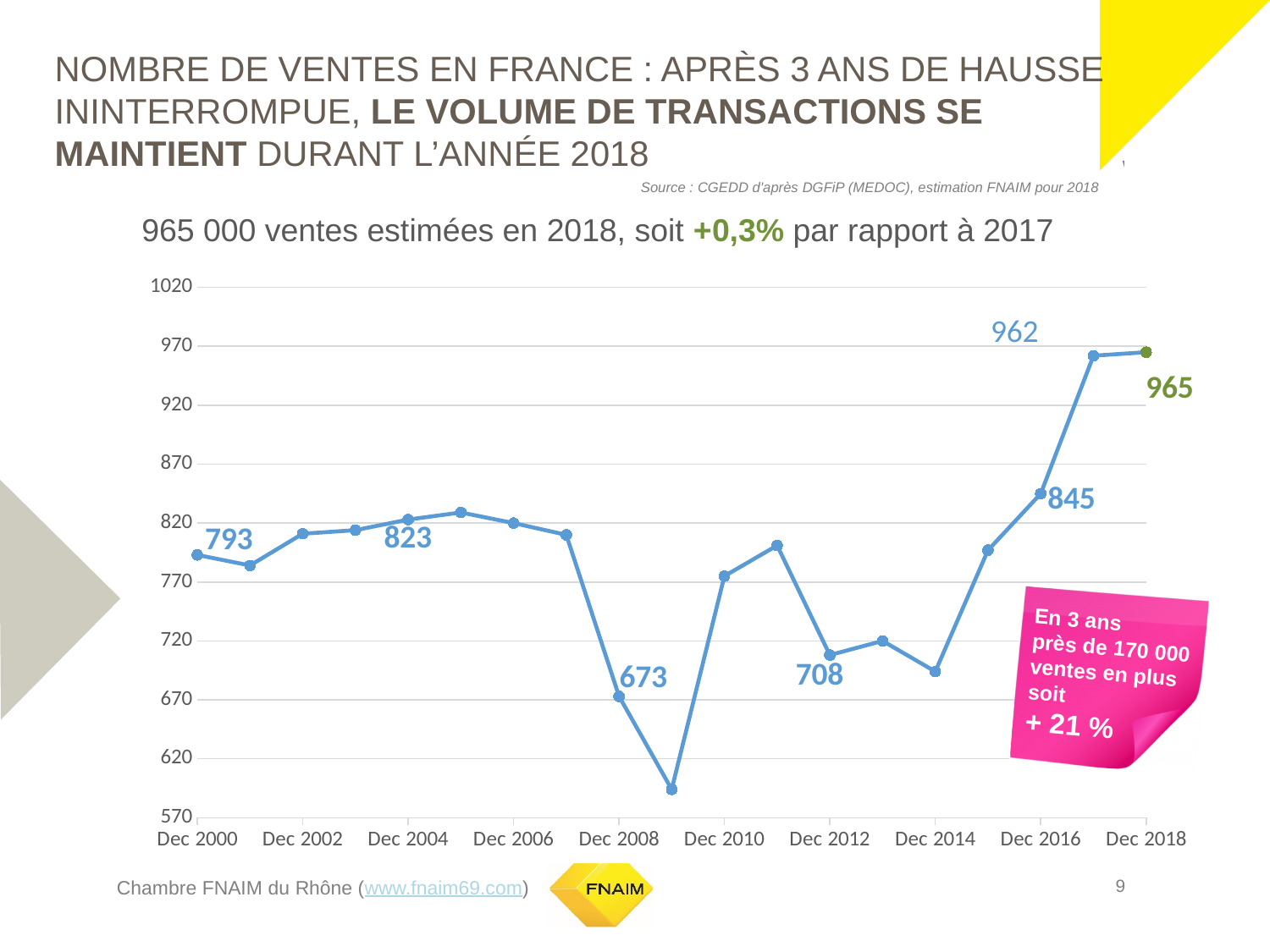
What is the value plotted for Dec 2018? 965 What is the difference between the values for Dec 2016 and Dec 2012? 137 What is the value plotted for Dec 2008? 673 What is the value plotted for Dec 2000? 793 Do the values rise or fall between Dec 2014 and Dec 2018? rise What is the value plotted for Dec 2016? 845 Which labelled point has the highest value on the chart? Dec 2018 How many data points are plotted on the line? 19 Is the value for Dec 2009 greater or less than 620? less What type of chart is shown on the slide? line chart What is the difference between the values for Dec 2018 and Dec 2008? 292 Which is larger, the value for Dec 2004 or the value for Dec 2012? Dec 2004